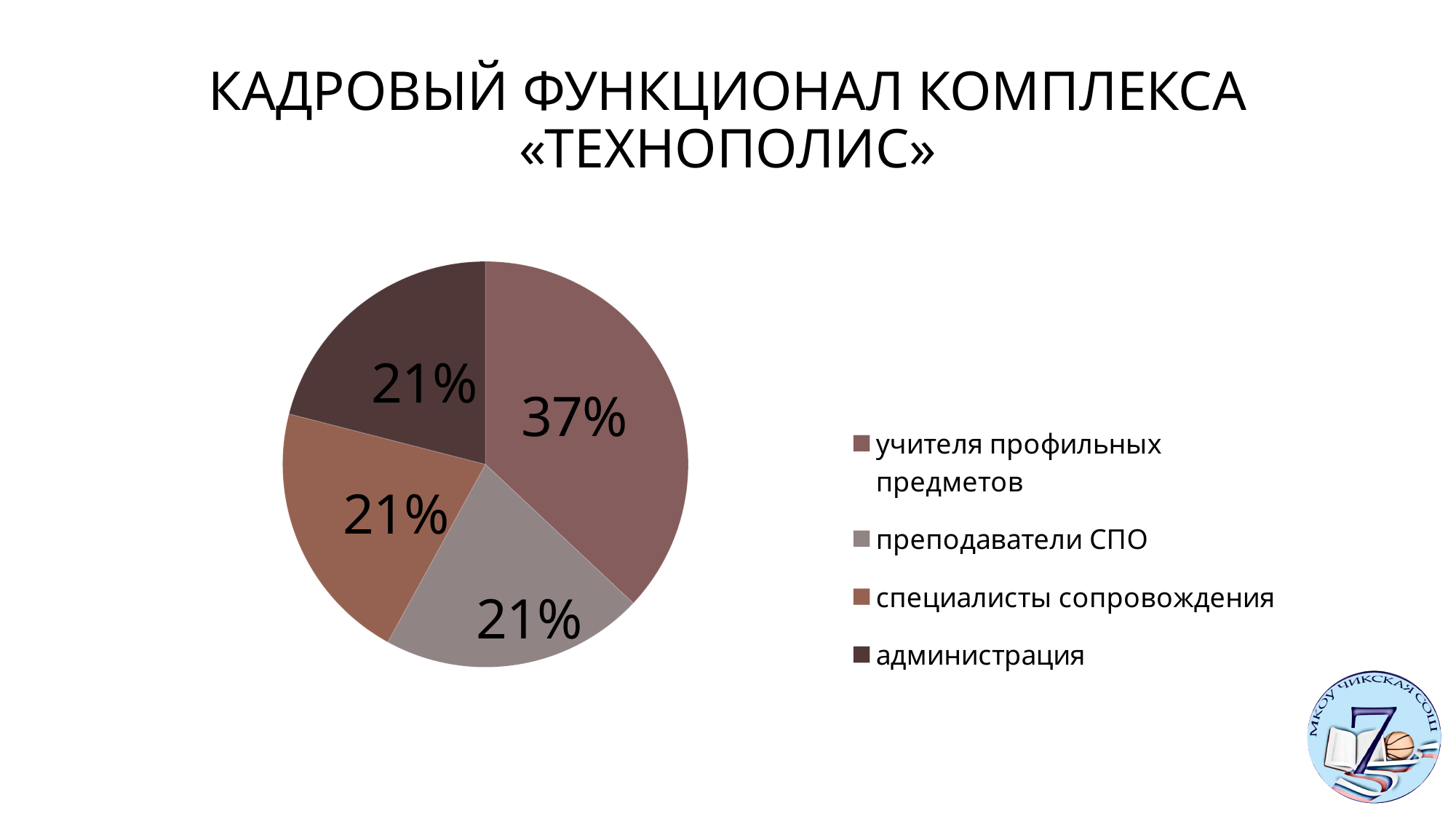
What share of the pie is labelled for учителя профильных предметов? 37% Which legend entry is shown with the darkest colour? администрация What percentage is shown for администрация? 21% How many entries does the legend list? 4 What percentage is shown for преподаватели СПО? 21% Which is larger: the slice for учителя профильных предметов or the slice for администрация? учителя профильных предметов How many slices does the pie chart have? 4 Which category has the largest slice of the pie? учителя профильных предметов What percentage is shown for специалисты сопровождения? 21% What kind of chart is shown on the slide? pie chart By how many percentage points does the slice for учителя профильных предметов exceed the slice for преподаватели СПО? 16 What is the title shown above the pie chart on the slide? КАДРОВЫЙ ФУНКЦИОНАЛ КОМПЛЕКСА «ТЕХНОПОЛИС»